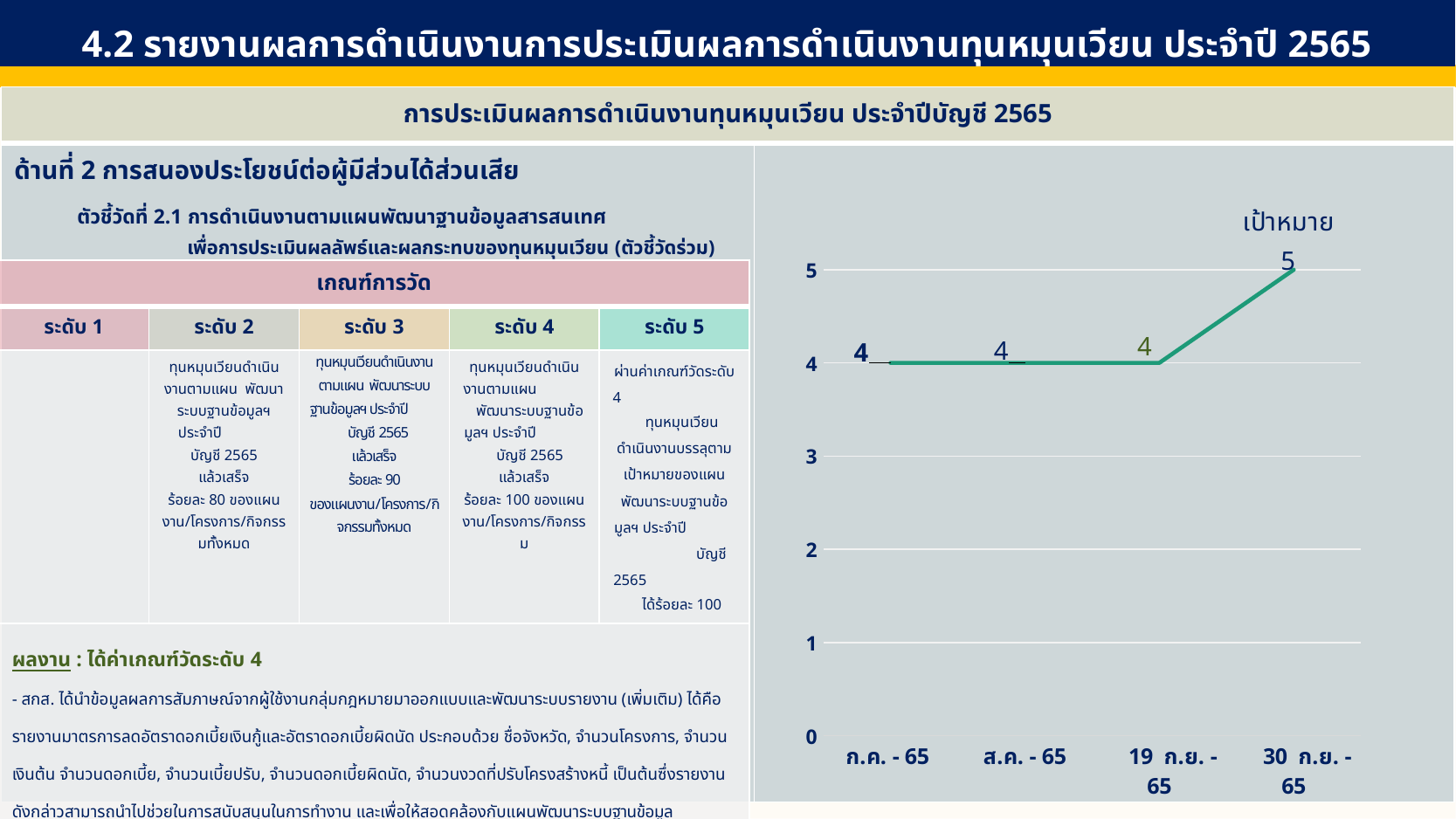
Which is larger, the value for ส.ค. - 65 or the value for 30 ก.ย. - 65? 30 ก.ย. - 65 What is the value for 19 ก.ย. - 65 on the chart? 4 Do the values on the chart rise or fall from ก.ค. - 65 to 30 ก.ย. - 65? rise What is the value for ส.ค. - 65 on the chart? 4 What is the difference between the values for 30 ก.ย. - 65 and 19 ก.ย. - 65? 1 How many data points are plotted on the chart? 4 What label appears above the last data point on the chart? เป้าหมาย Which category has the highest value on the chart? 30 ก.ย. - 65 What is the highest value shown on the chart's vertical axis? 5 What is the value for 30 ก.ย. - 65 on the chart? 5 What is the value for ก.ค. - 65 on the chart? 4 What kind of chart is shown on the slide? line chart